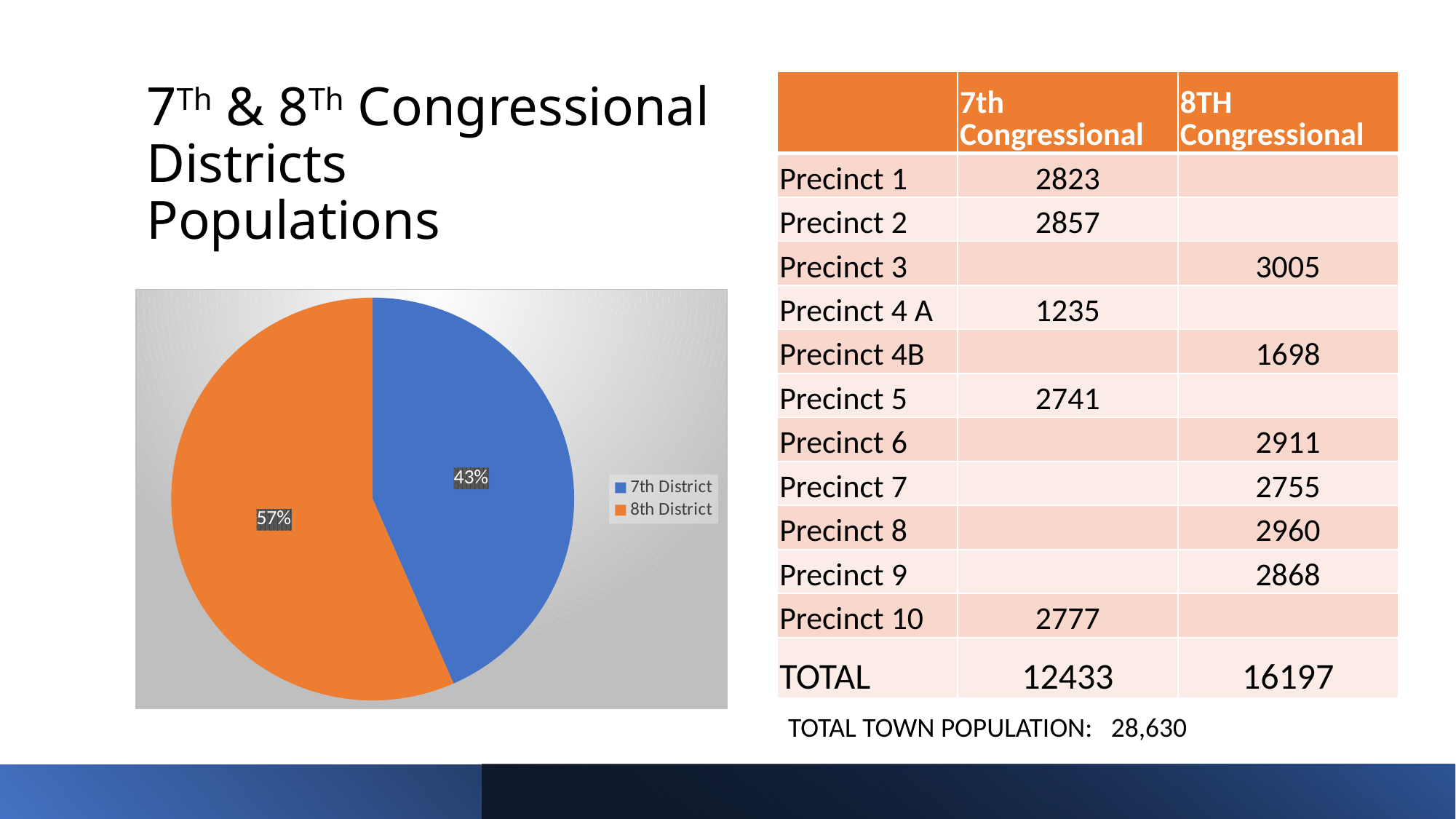
What share of the pie does the 7th District slice represent? 43% Which district has the smaller slice of the pie? 7th District Which district has the larger slice of the pie? 8th District What is the difference in percentage points between the 8th District and 7th District slices? 14% How many entries does the legend list? 2 What kind of chart is shown on the slide? pie chart What colour is the 8th District slice in the pie chart? orange Is the 7th District slice larger or smaller than the 8th District slice? smaller How many slices does the pie chart have? 2 What colour is the 7th District slice in the pie chart? blue What share of the pie does the 8th District slice represent? 57%